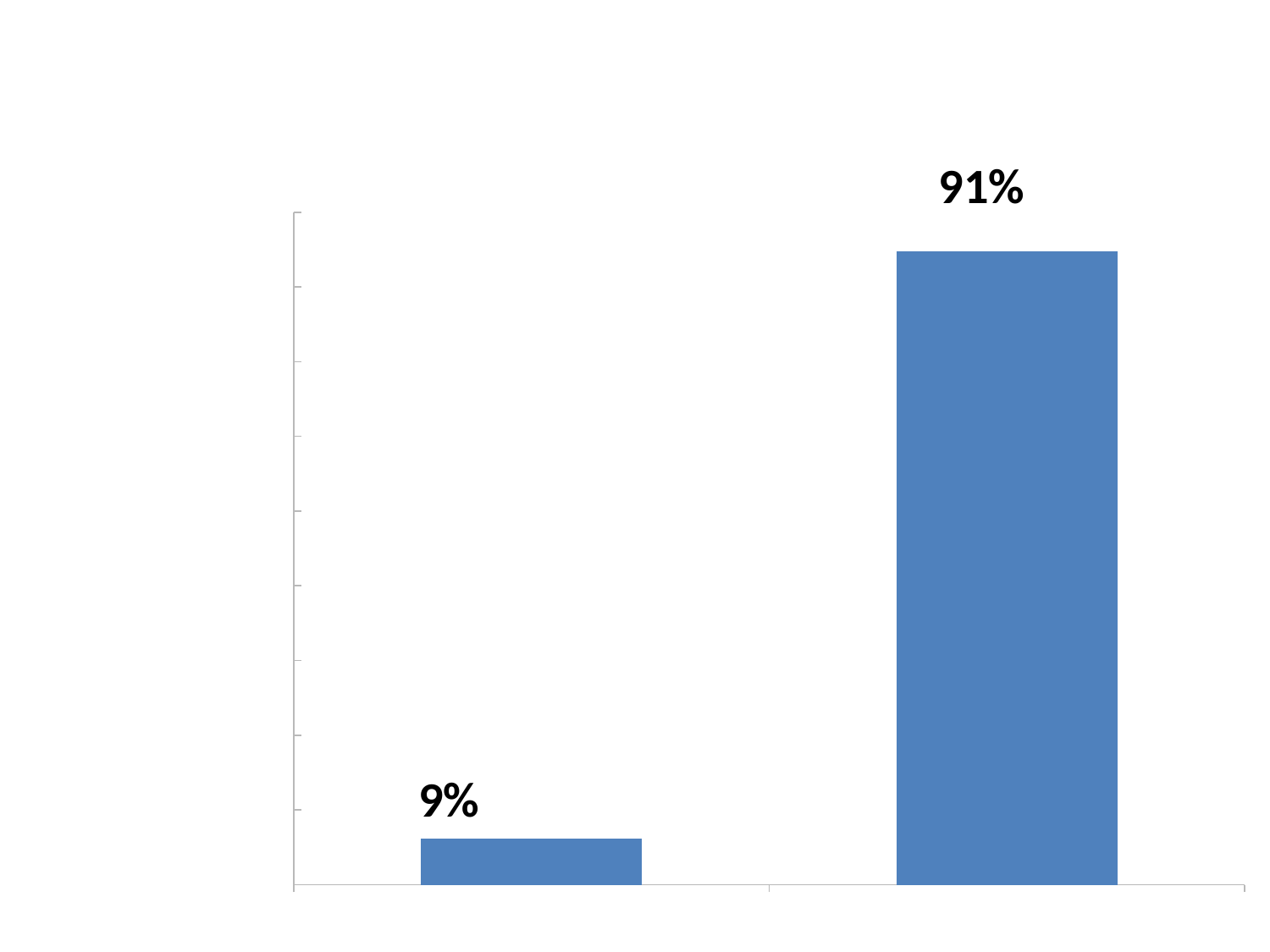
What colour are the bars in the chart? blue What value is shown on the left bar? 9% What is the difference between the right bar's value and the left bar's value? 82% Which bar has the highest value, the left or the right? right What kind of chart is shown on the slide? bar chart Is the value of the right bar larger or smaller than the value of the left bar? larger What value is shown on the right bar? 91% What is the total of the two bar values shown? 100% Which bar has the lowest value, the left or the right? left How many bars are plotted in the chart? 2 Does the chart display a legend? no